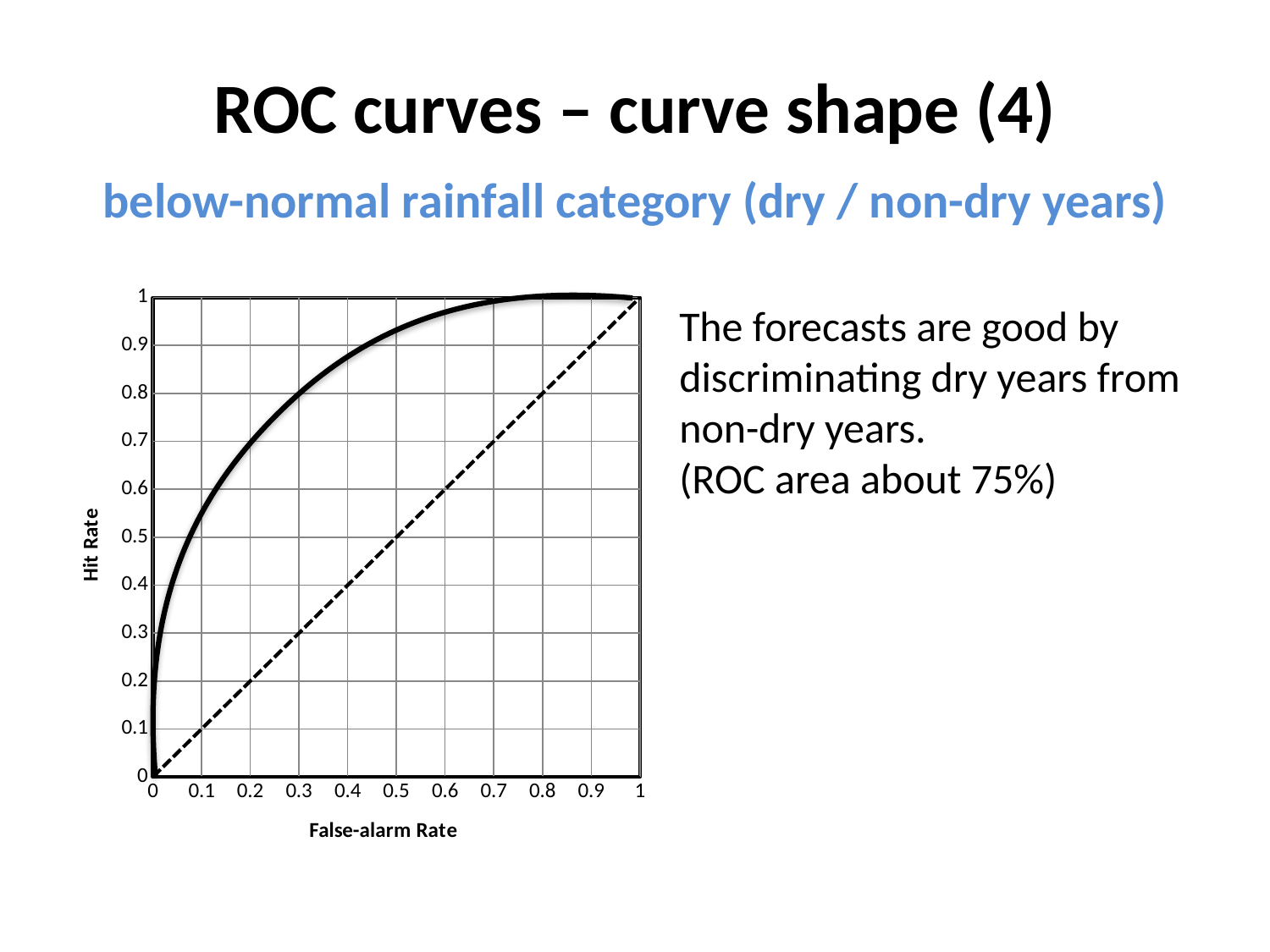
What kind of chart is shown on the slide? line chart At a false-alarm rate of 0.2, is the hit rate of the solid curve greater or less than 0.5? greater What is the label of the x axis of the chart? False-alarm Rate At a false-alarm rate of 0.3, is the hit rate of the dashed line greater or less than 0.5? less At a false-alarm rate of 0.5, which line has the higher hit rate, the solid curve or the dashed line? the solid curve Does the solid curve rise or fall as the false-alarm rate increases from 0 to 1? rise What is the highest value shown on the y axis of the chart? 1 At a false-alarm rate of 0.1, is the hit rate of the solid curve greater or less than 0.4? greater What is the label of the y axis of the chart? Hit Rate How many lines are plotted on the chart? 2